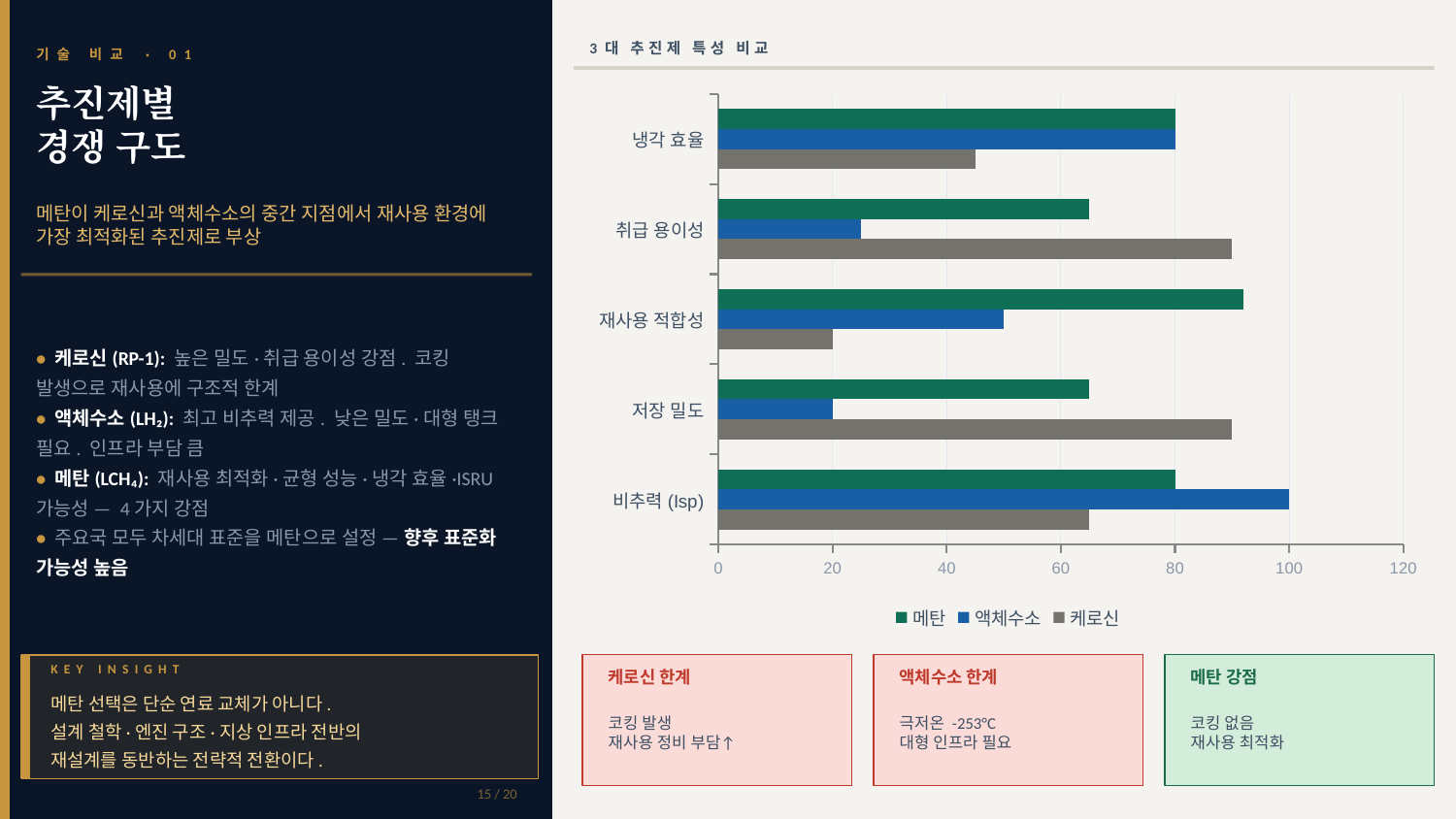
For 저장 밀도, which is larger: the value for 메탄 or the value for 액체수소? 메탄 Which series has the lowest value for 재사용 적합성? 케로신 Is the value of 액체수소 for 취급 용이성 greater or less than 40? less How many series does the chart legend list? 3 What is the title of the chart? 3대 추진제 특성 비교 What kind of chart is shown on the slide? bar chart Is the value of 케로신 for 냉각 효율 greater or less than 60? less Is the value of 메탄 for 재사용 적합성 greater or less than 80? greater Which series is shown in green in the chart legend? 메탄 Which series has the highest value for 취급 용이성? 케로신 Which series has the highest value for 비추력 (Isp)? 액체수소 How many categories are plotted on the chart? 5